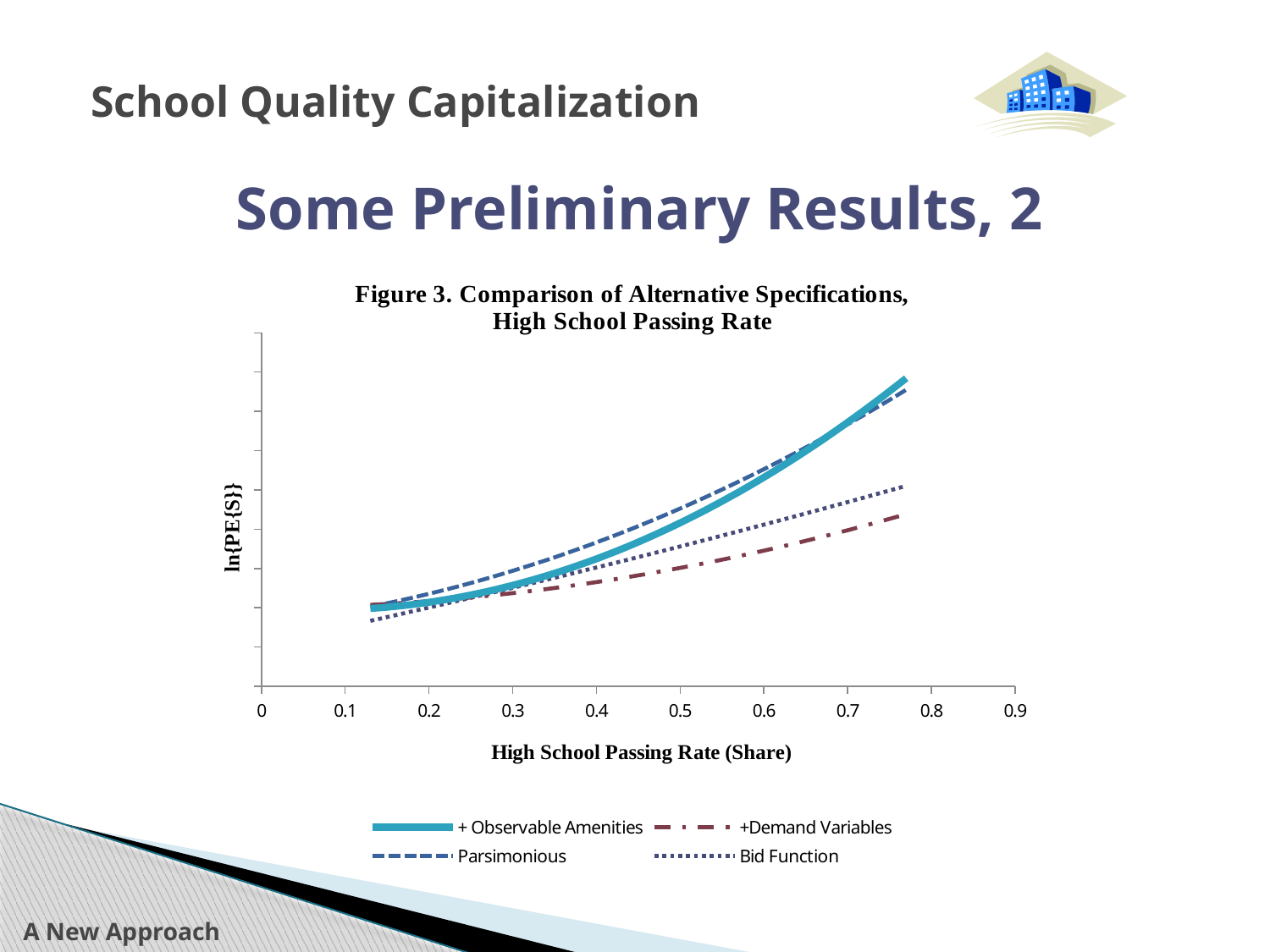
Do the values of the +Demand Variables series rise or fall along the x axis? rise How many series does the legend list? 4 At a High School Passing Rate of 0.7, which is higher: the + Observable Amenities series or the +Demand Variables series? + Observable Amenities What is the label of the x axis? High School Passing Rate (Share) At a High School Passing Rate of 0.7, which is higher: the Parsimonious series or the Bid Function series? Parsimonious At a High School Passing Rate of 0.6, which is higher: the Bid Function series or the +Demand Variables series? Bid Function What kind of chart is shown on the slide? line chart Do the values of the + Observable Amenities series rise or fall as the High School Passing Rate increases? rise Which series has the lowest value at the right end of the chart (around a passing rate of 0.75)? +Demand Variables How many tick labels are shown on the x axis? 10 What is the title of the chart? Figure 3. Comparison of Alternative Specifications, High School Passing Rate What is the highest value labelled on the x axis? 0.9